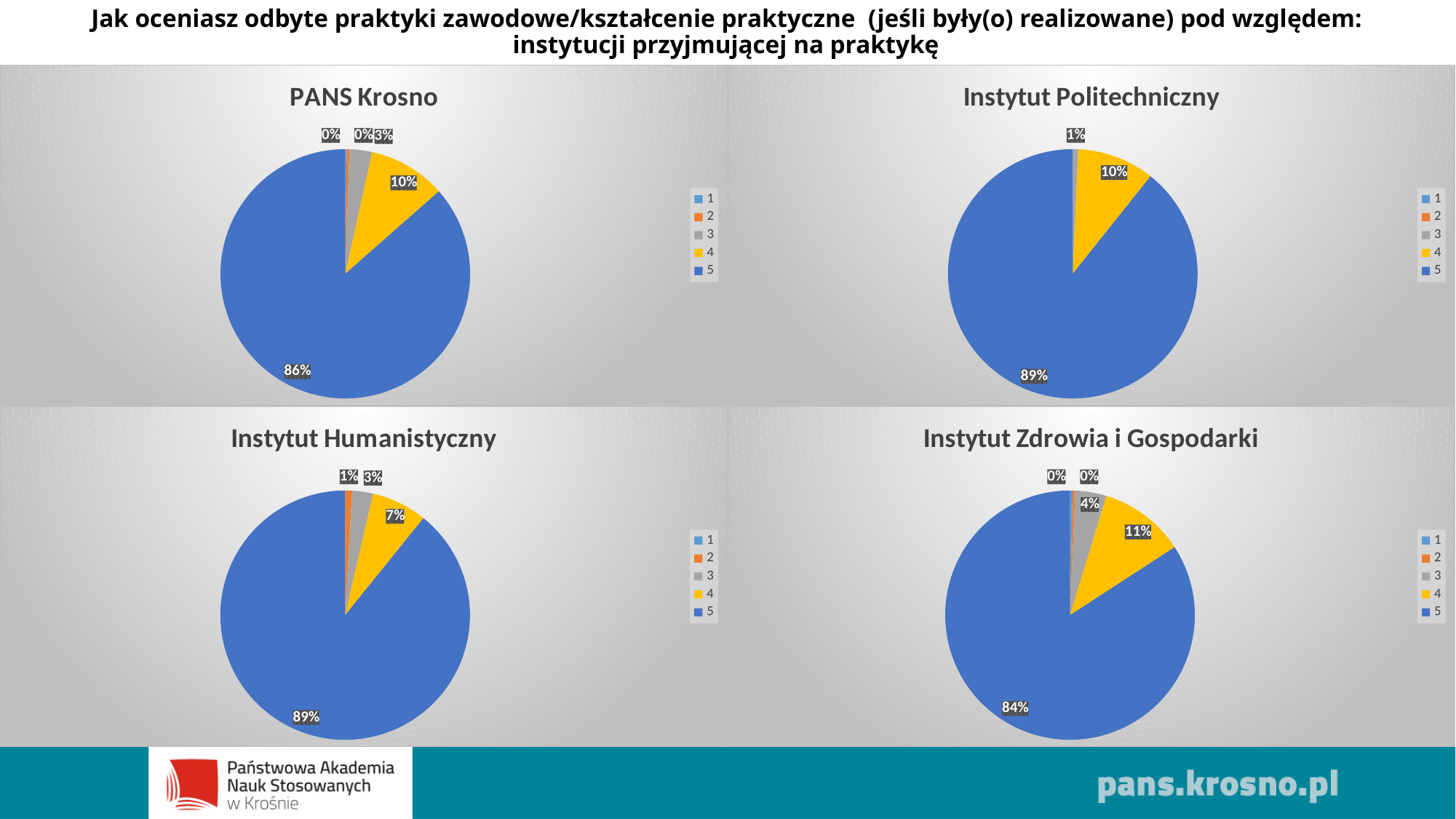
How many charts are shown on the slide? 4 In the PANS Krosno chart, which category has the largest slice? 5 In the PANS Krosno chart, what share does category 5 have? 86% In the Instytut Humanistyczny chart, which category has the largest slice? 5 In the Instytut Zdrowia i Gospodarki chart, what share does category 4 have? 11% How many categories does the legend of the PANS Krosno chart list? 5 In the Instytut Humanistyczny chart, what share does category 4 have? 7% What is the difference between the category 4 share in the Instytut Zdrowia i Gospodarki chart and the category 4 share in the Instytut Humanistyczny chart? 4% In the Instytut Politechniczny chart, what share does category 5 have? 89% Which is larger: the category 5 share in the Instytut Politechniczny chart or the category 5 share in the Instytut Zdrowia i Gospodarki chart? Instytut Politechniczny What type of chart is the Instytut Politechniczny chart? Pie chart In the Instytut Zdrowia i Gospodarki chart, what share does category 3 have? 4%